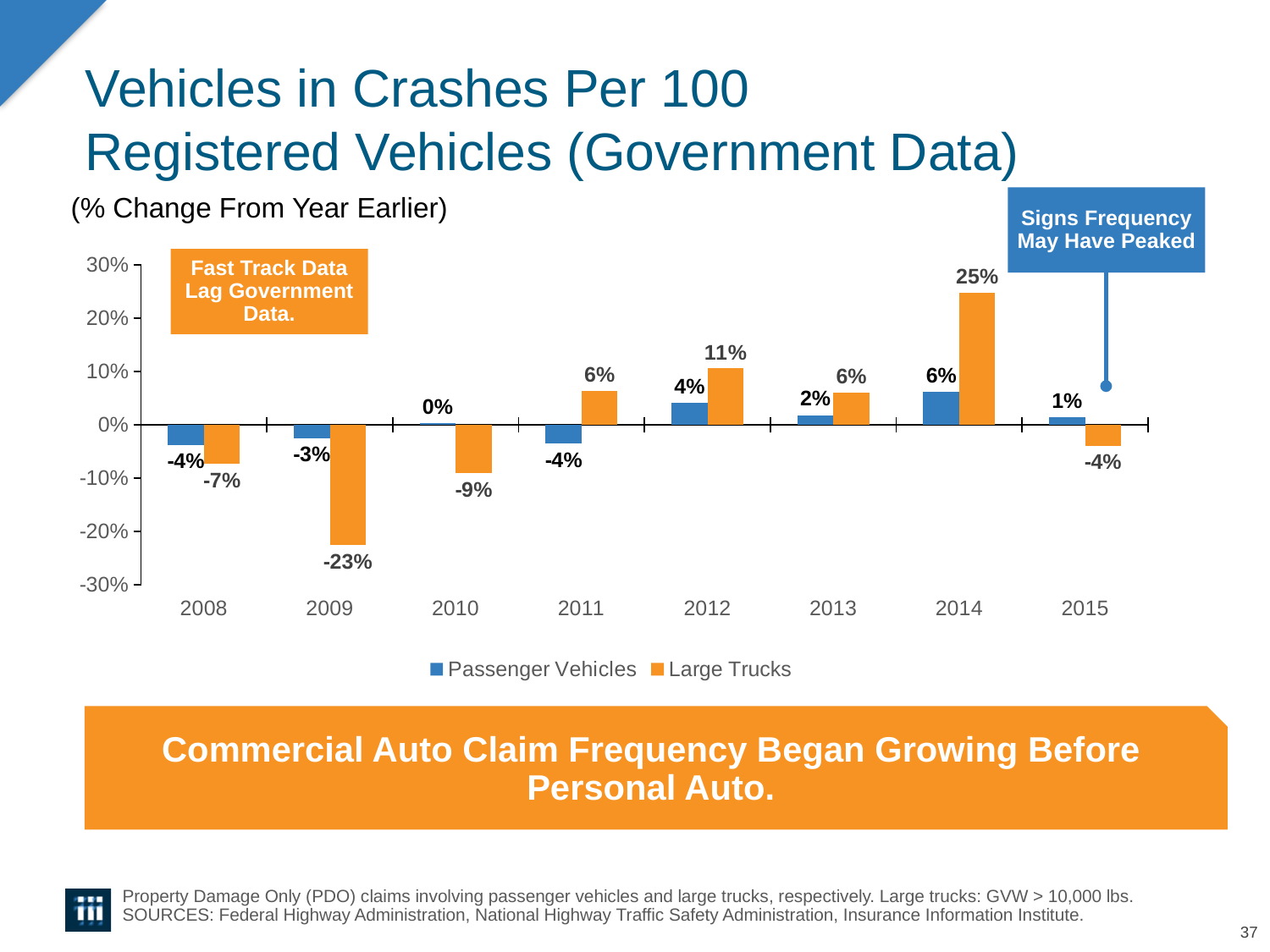
What kind of chart is shown on the slide? Bar chart What is the value for Large Trucks in 2009? -23% How many series does the legend list? 2 In 2015, which series has the larger value, Passenger Vehicles or Large Trucks? Passenger Vehicles Is the Large Trucks value for 2014 greater or less than 20%? greater How many years are shown on the x axis? 8 What is the difference between the Large Trucks and Passenger Vehicles values in 2014? 19 percentage points In which year is the Large Trucks value lowest? 2009 Which colour represents Large Trucks in the chart? Orange What is the value for Passenger Vehicles in 2011? -4% In which year is the Passenger Vehicles value highest? 2014 What is the value for Large Trucks in 2014? 25%